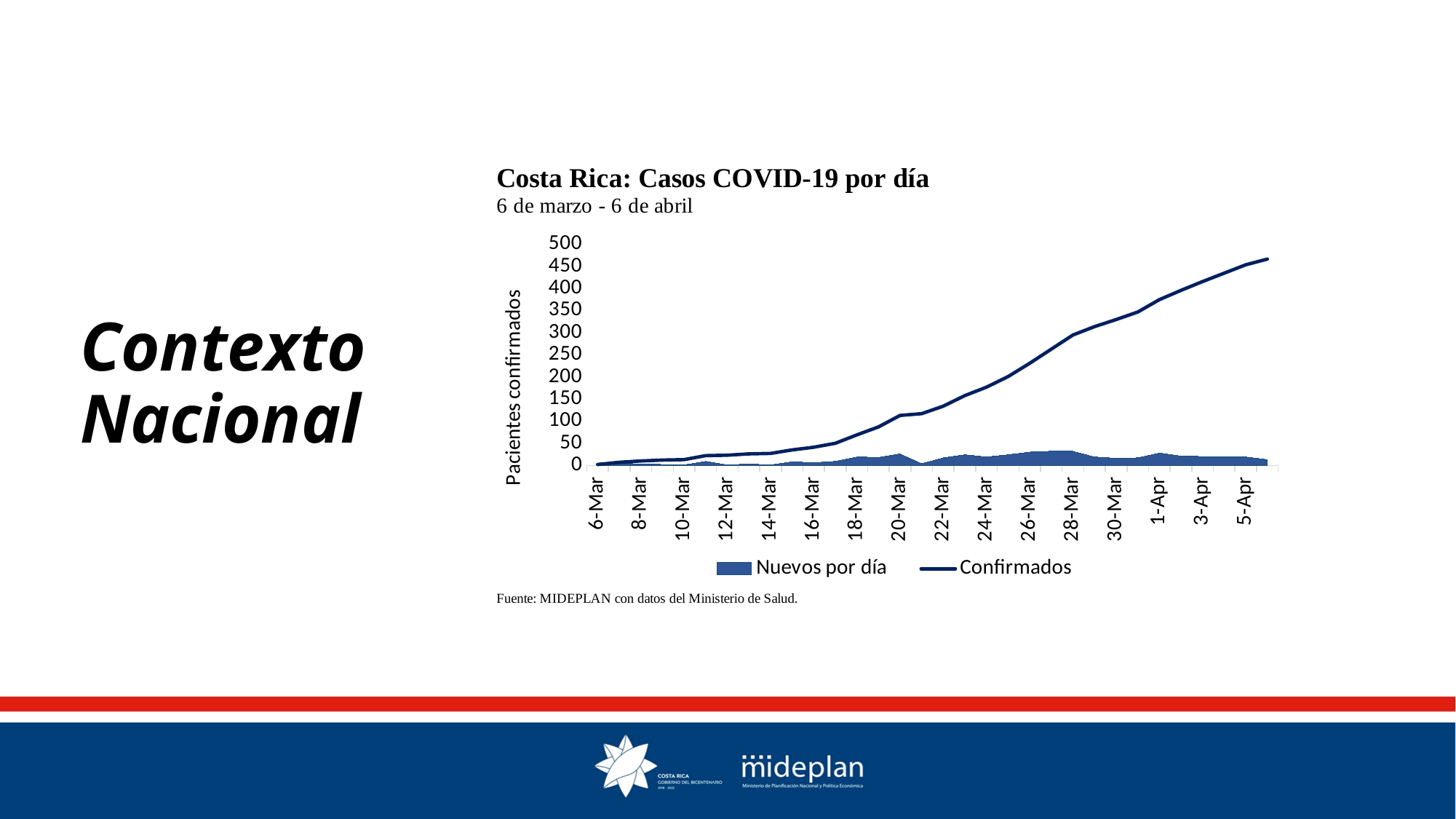
Is the Confirmados value on 28-Mar greater or less than 250? greater Does the Confirmados series rise or fall from 6-Mar to 5-Apr? rise Is the Confirmados value on 20-Mar greater or less than 150? less What is the title of the chart? Costa Rica: Casos COVID-19 por día What kind of chart is used for the Confirmados series? line chart Is the Confirmados value on 5-Apr greater or less than 400? greater How many date labels are shown on the x axis? 16 What are the two series named in the legend? Nuevos por día and Confirmados How many series does the chart legend list? 2 Which series reaches higher values on the chart, Nuevos por día or Confirmados? Confirmados